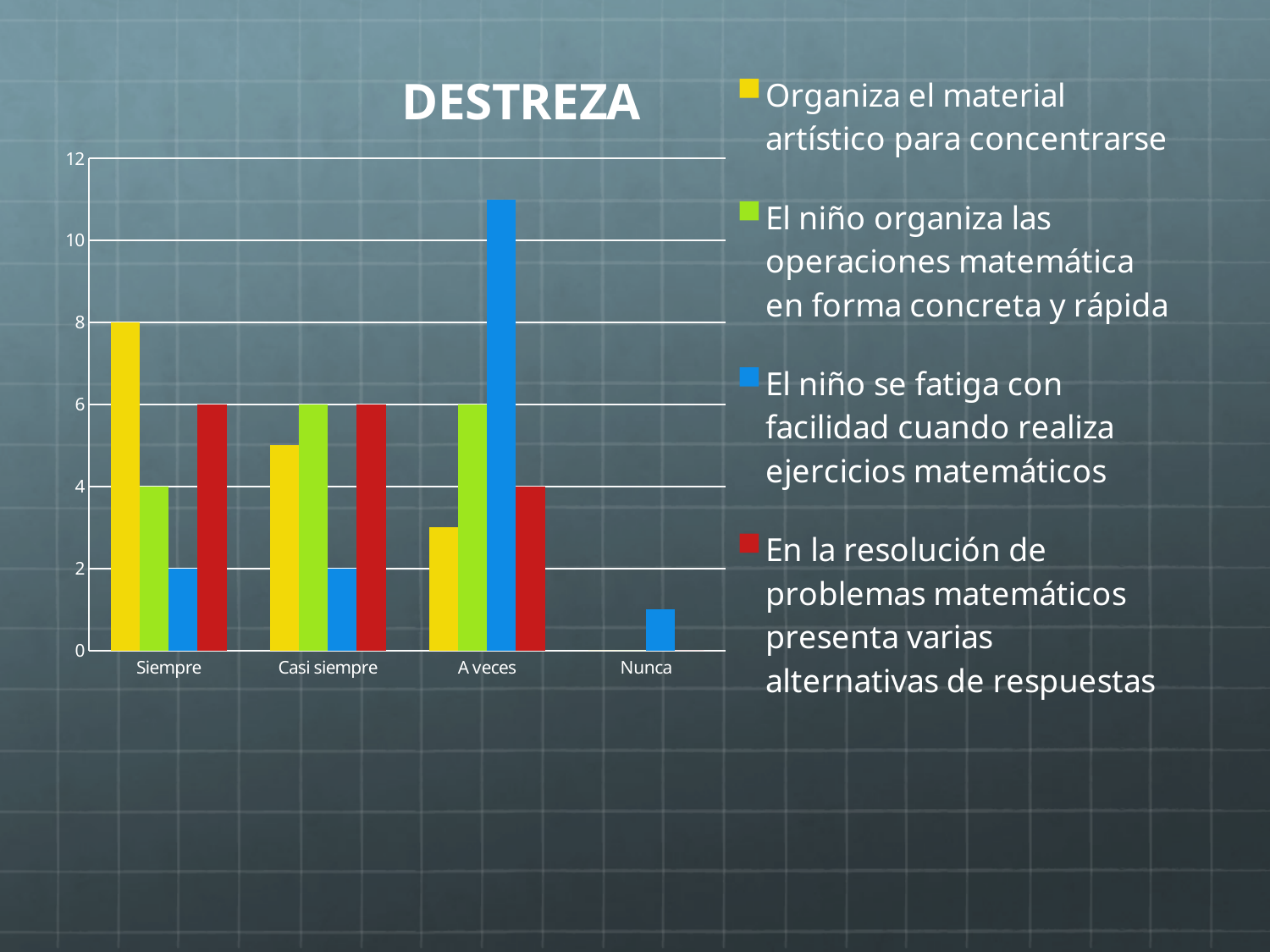
What is the difference between the 'Siempre' values of the series 'Organiza el material artístico para concentrarse' and 'El niño se fatiga con facilidad cuando realiza ejercicios matemáticos'? 6 How many categories are shown on the x axis of the chart? 4 What kind of chart is shown on the slide? bar chart What is the value for 'Casi siempre' in the series 'En la resolución de problemas matemáticos presenta varias alternativas de respuestas'? 6 What is the title of the chart? DESTREZA What is the value for 'Siempre' in the series 'Organiza el material artístico para concentrarse'? 8 Which category has the highest value in the series 'El niño se fatiga con facilidad cuando realiza ejercicios matemáticos'? A veces Is the value for 'A veces' in the series 'El niño se fatiga con facilidad cuando realiza ejercicios matemáticos' greater or less than 10? greater What is the value for 'A veces' in the series 'El niño organiza las operaciones matemática en forma concreta y rápida'? 6 What is the value for 'Siempre' in the series 'El niño organiza las operaciones matemática en forma concreta y rápida'? 4 How many series does the chart's legend list? 4 Which is larger for 'Siempre': the value for 'Organiza el material artístico para concentrarse' or the value for 'En la resolución de problemas matemáticos presenta varias alternativas de respuestas'? Organiza el material artístico para concentrarse